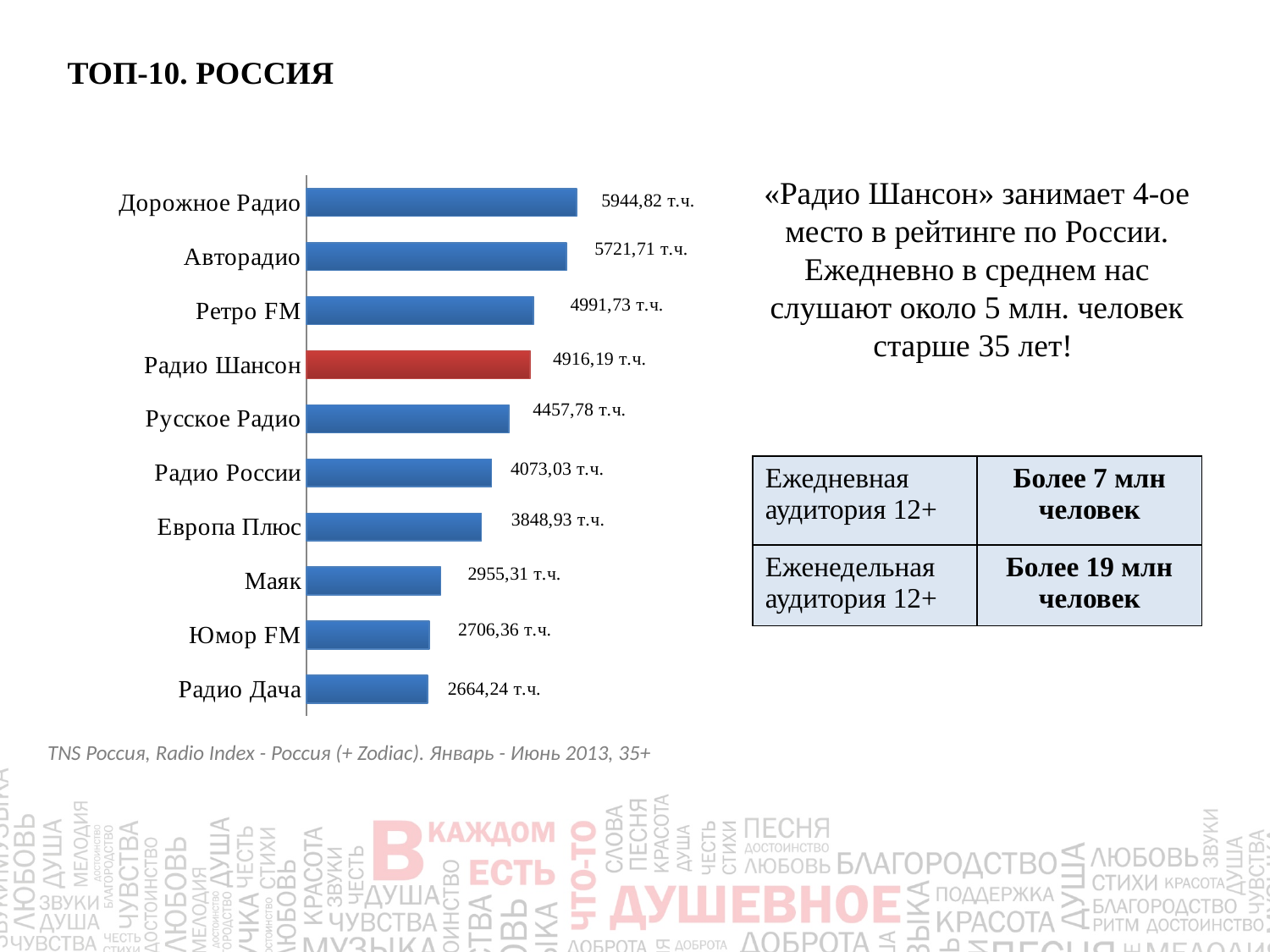
What is the difference between the values for Дорожное Радио and Авторадио? 223,11 т.ч. Which has a larger value, Русское Радио or Радио России? Русское Радио Which radio station's bar is coloured red instead of blue? Радио Шансон Which radio station has the lowest value in the chart? Радио Дача Which radio station has the highest value in the chart? Дорожное Радио What is the value shown for Маяк? 2955,31 т.ч. What is the value shown for Дорожное Радио? 5944,82 т.ч. What type of chart is shown on the slide? Bar chart What is the difference between the values for Ретро FM and Радио Шансон? 75,54 т.ч. Which has a larger value, Европа Плюс or Маяк? Европа Плюс What is the value shown for Радио Шансон? 4916,19 т.ч. How many radio stations are shown in the chart? 10